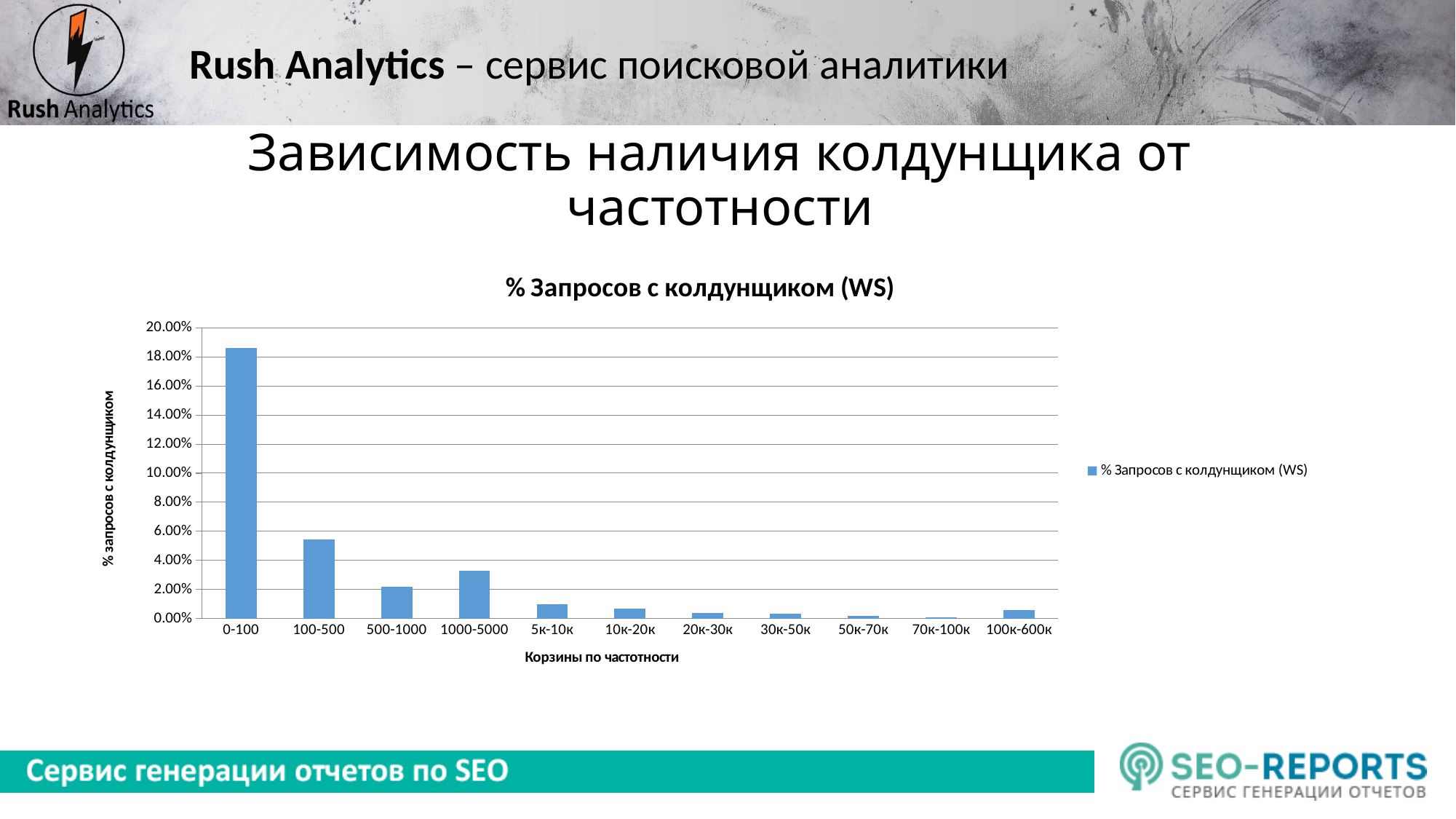
Which frequency bin has the highest share of queries with a колдунщик? 0-100 Is the value for 0-100 greater or less than 18.00%? greater What is the title of the chart? % Запросов с колдунщиком (WS) How many series does the legend list? 1 Which bin has a larger value: 1000-5000 or 500-1000? 1000-5000 Which frequency bin has the lowest share of queries with a колдунщик? 70к-100к How many frequency bins (categories) are shown on the x axis? 11 Is the value for 100-500 greater or less than 6.00%? less Is the value for 1000-5000 greater or less than 2.00%? greater What kind of chart is shown on the slide? bar chart Which bin has a larger value: 100к-600к or 20к-30к? 100к-600к What is the x-axis title of the chart? Корзины по частотности